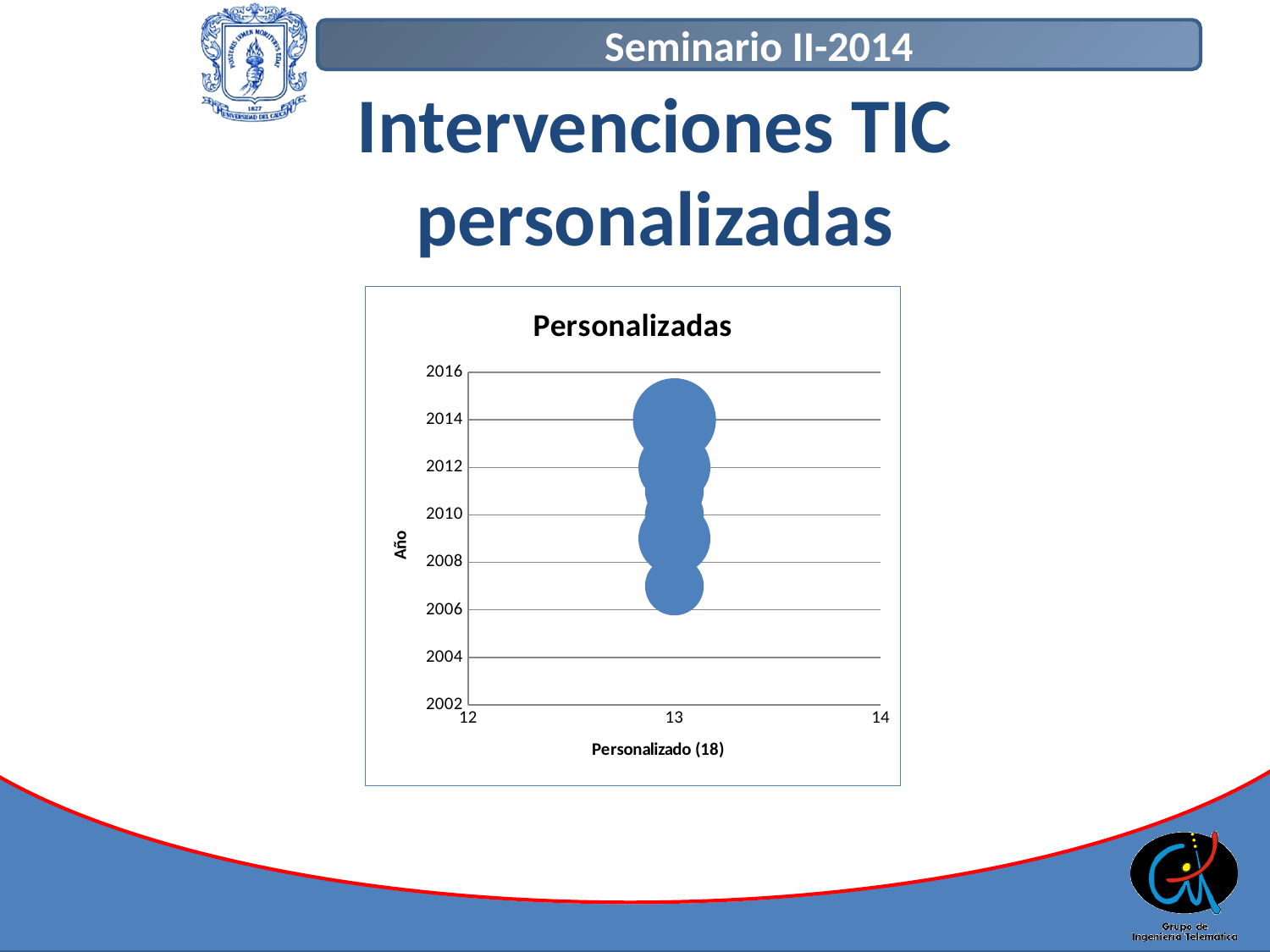
Which bubble is the largest: the topmost one (around 2014) or the lowest one (around 2007)? the topmost one (around 2014) What is the title of the chart? Personalizadas What kind of chart is shown on the slide? bubble chart Are any bubbles plotted below the year 2006 on the chart? No Is the year of the topmost bubble greater or less than 2012? greater At which value on the horizontal axis are all the bubbles centred? 13 Is the year of the lowest bubble greater or less than 2008? less What is the label of the vertical axis of the chart? Año